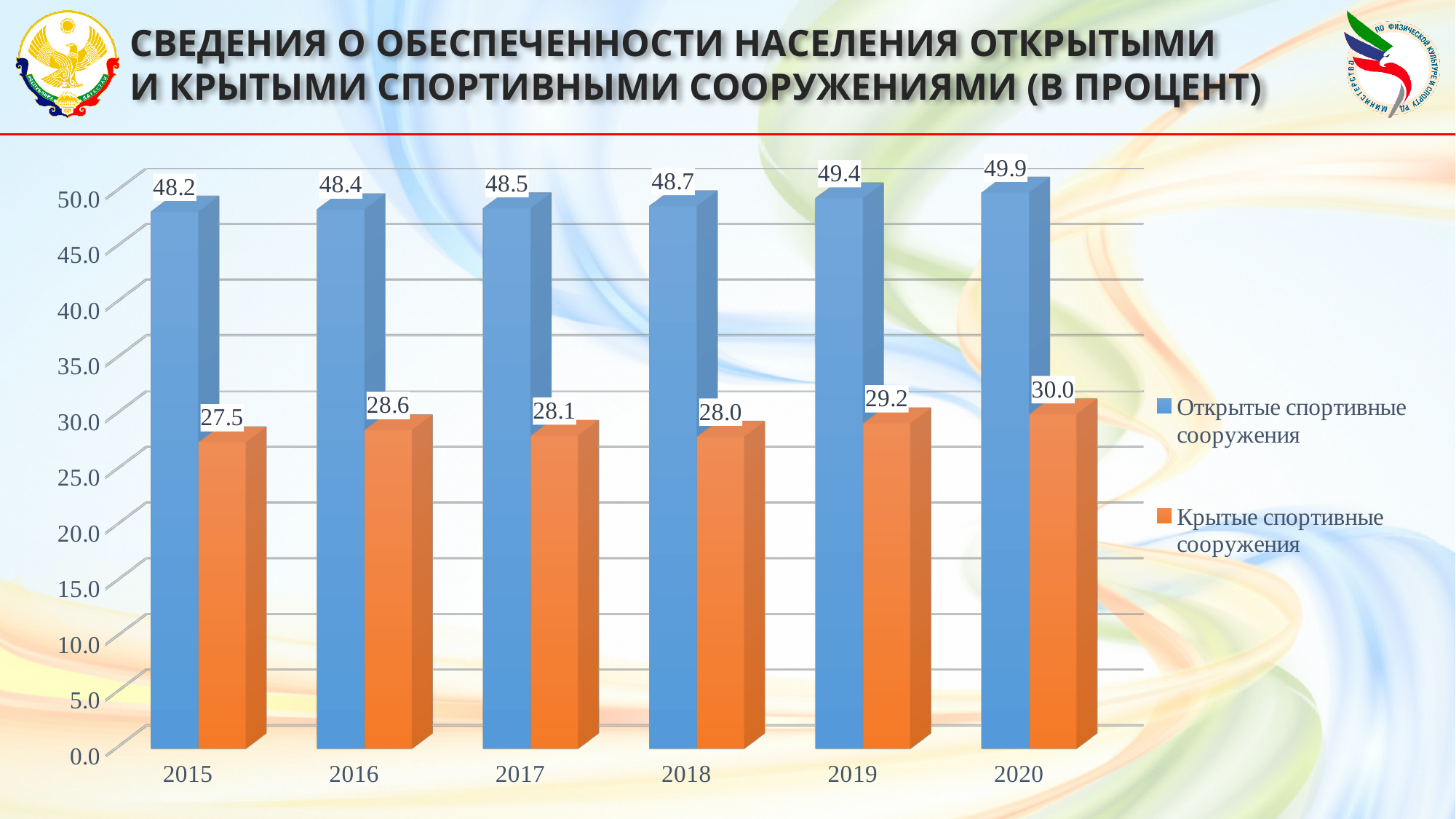
In which year is the value for Открытые спортивные сооружения highest? 2020 Is the value for Крытые спортивные сооружения in 2015 greater or less than 30.0? less How many years are shown on the x axis? 6 What is the value for Открытые спортивные сооружения in 2015? 48.2 In which year is the value for Крытые спортивные сооружения lowest? 2015 What kind of chart is shown on the slide? bar chart Do the values for Открытые спортивные сооружения rise or fall from 2015 to 2020? rise What is the value for Крытые спортивные сооружения in 2018? 28.0 How many series does the legend list? 2 What is the value for Крытые спортивные сооружения in 2020? 30.0 What is the difference between Открытые спортивные сооружения and Крытые спортивные сооружения in 2019? 20.2 Which is larger: Крытые спортивные сооружения in 2016 or in 2017? 2016